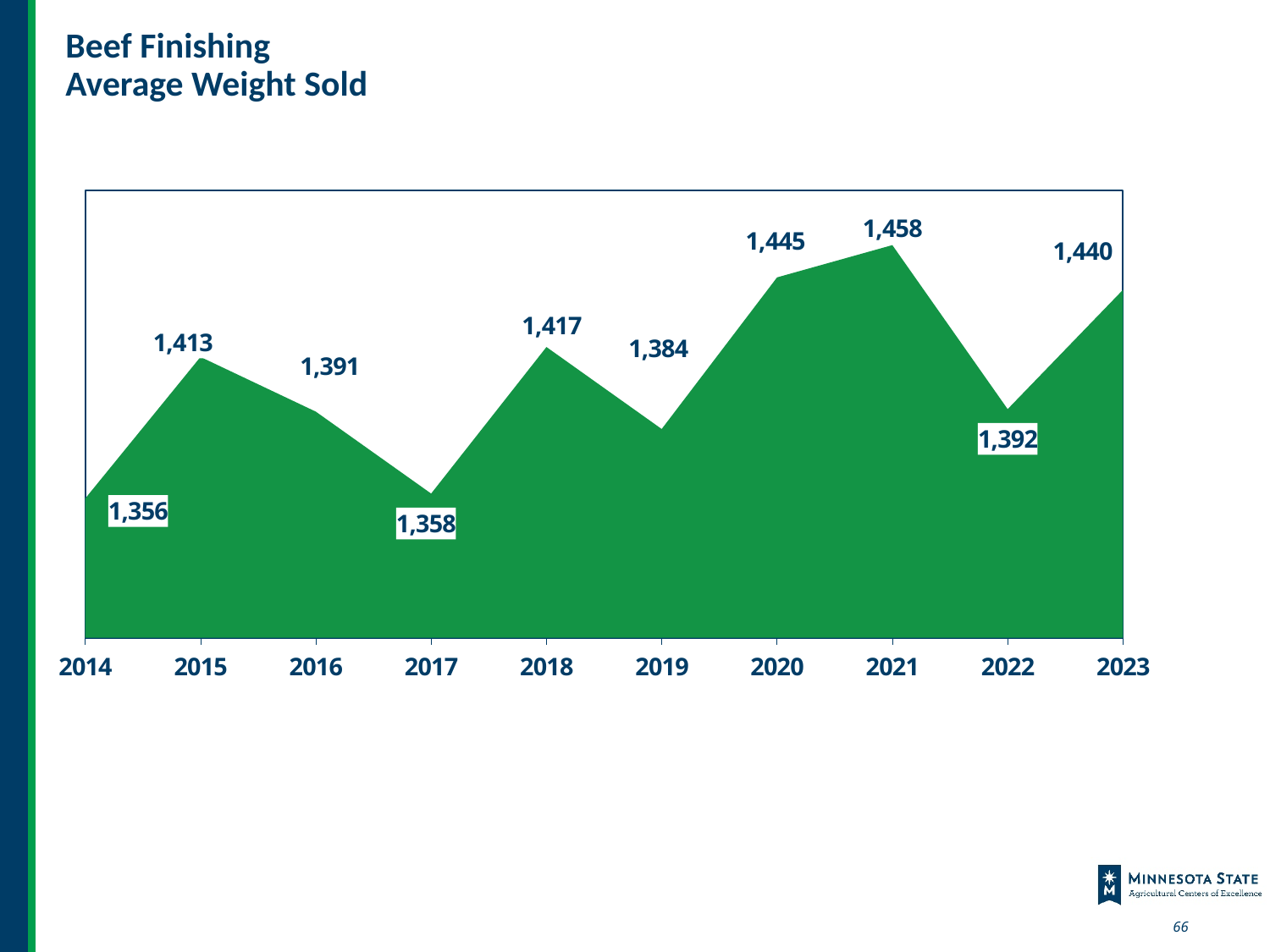
How many years are shown on the x axis? 10 What is the average weight sold in 2017? 1,358 What kind of chart is this? Area chart Which year has a higher average weight sold, 2018 or 2019? 2018 Which year has the highest average weight sold? 2021 Which year has the lowest average weight sold? 2014 What is the average weight sold in 2021? 1,458 What is the average weight sold in 2023? 1,440 What is the difference between the average weight sold in 2021 and in 2014? 102 Did the average weight sold rise or fall from 2021 to 2022? Fall What is the difference between the average weight sold in 2022 and in 2023? 48 What is the average weight sold in 2014? 1,356